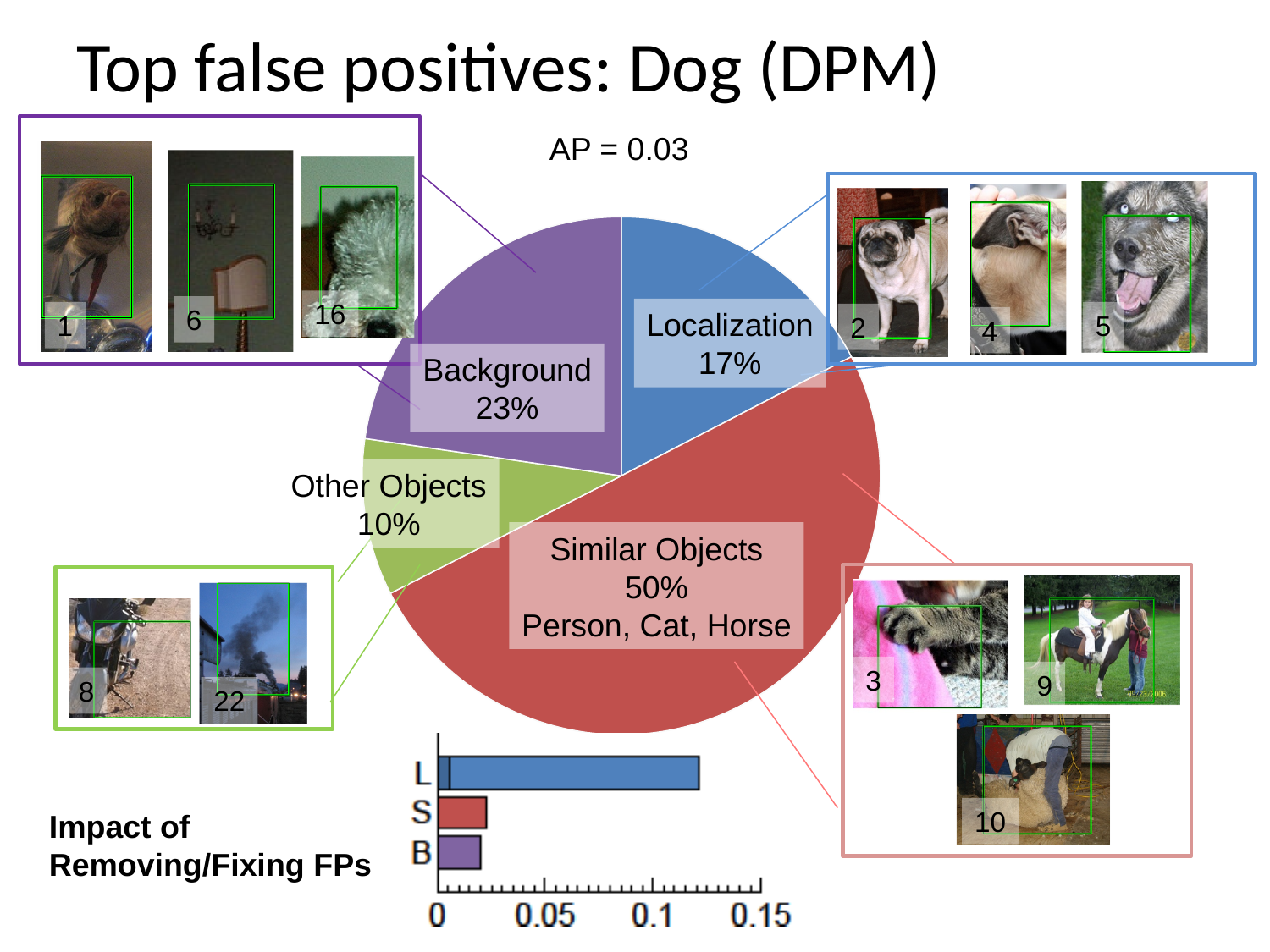
In the pie chart, what share of false positives is attributed to Similar Objects? 50% In the pie chart, what percentage is labelled for Background? 23% In the pie chart, which category has the smallest share? Other Objects In the pie chart, what percentage is labelled for Other Objects? 10% In the pie chart, what is the difference in percentage points between Background and Localization? 6 How many slices does the pie chart have? 4 In the pie chart, which category has the largest share? Similar Objects In the 'Impact of Removing/Fixing FPs' bar chart, is the value for L greater or less than 0.1? greater In the pie chart, what percentage is labelled for Localization? 17% What kind of chart is the 'Impact of Removing/Fixing FPs' chart at the bottom of the slide? bar chart In the 'Impact of Removing/Fixing FPs' bar chart, which bar is the longest? L In the pie chart, which is larger: Background or Localization? Background